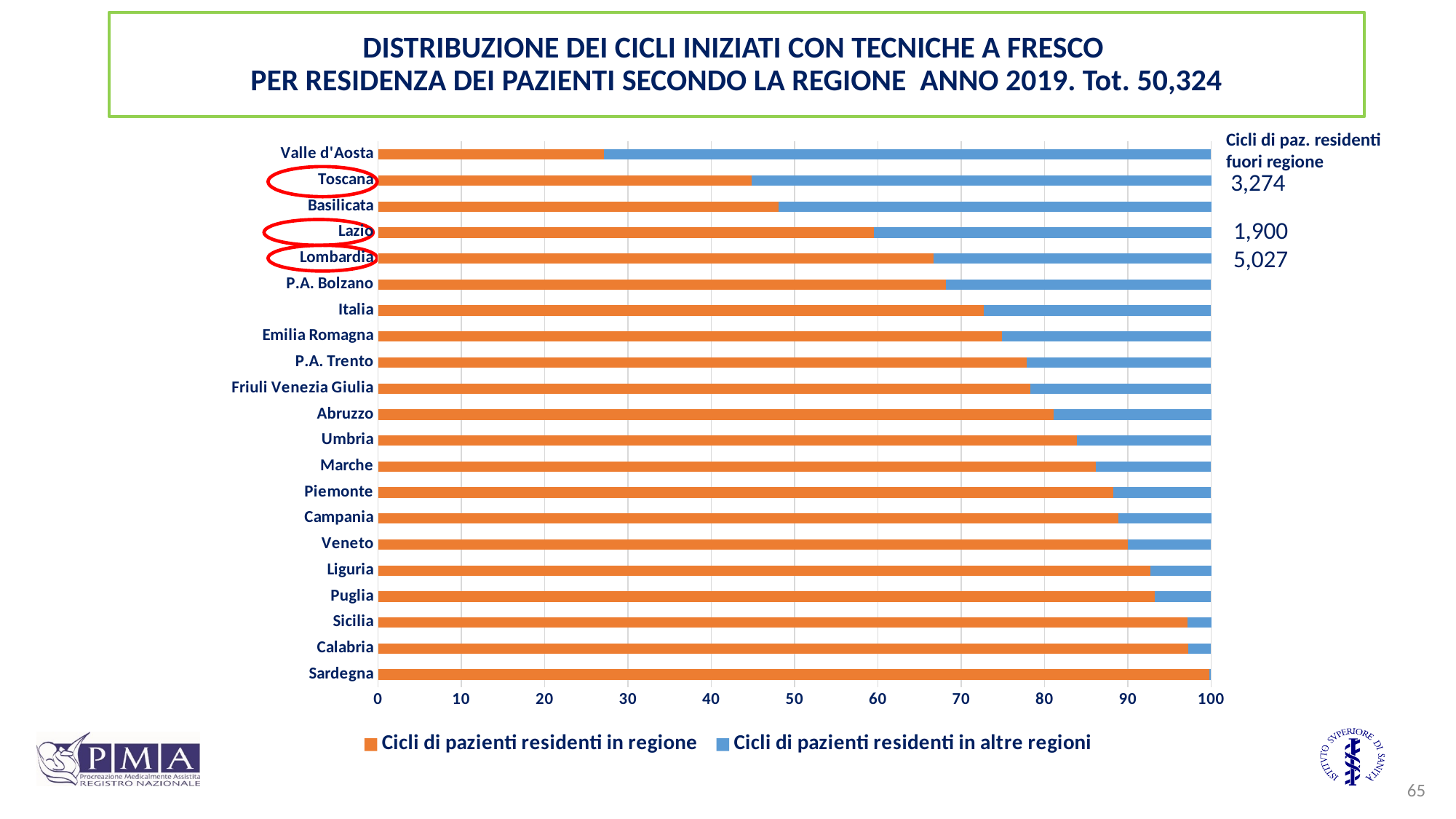
Which has more cycles of patients resident outside the region, Toscana or Lazio? Toscana How many regions (categories) are listed on the chart's vertical axis? 21 Is the share of cycles from patients resident in the region for Marche greater or less than 80? greater Is the share of cycles from patients resident in the region for Valle d'Aosta greater or less than 30? less How many series does the legend list? 2 How many cycles of patients resident outside the region are reported for Toscana? 3,274 Which region has the highest share of cycles from patients resident in the region? Sardegna How many cycles of patients resident outside the region are reported for Lombardia? 5,027 Is the share of cycles from patients resident in the region for Toscana greater or less than 50? less Which region has the lowest share of cycles from patients resident in the region? Valle d'Aosta What kind of chart is shown on the slide? bar chart What is the difference between the number of out-of-region cycles for Lombardia and for Toscana? 1,753